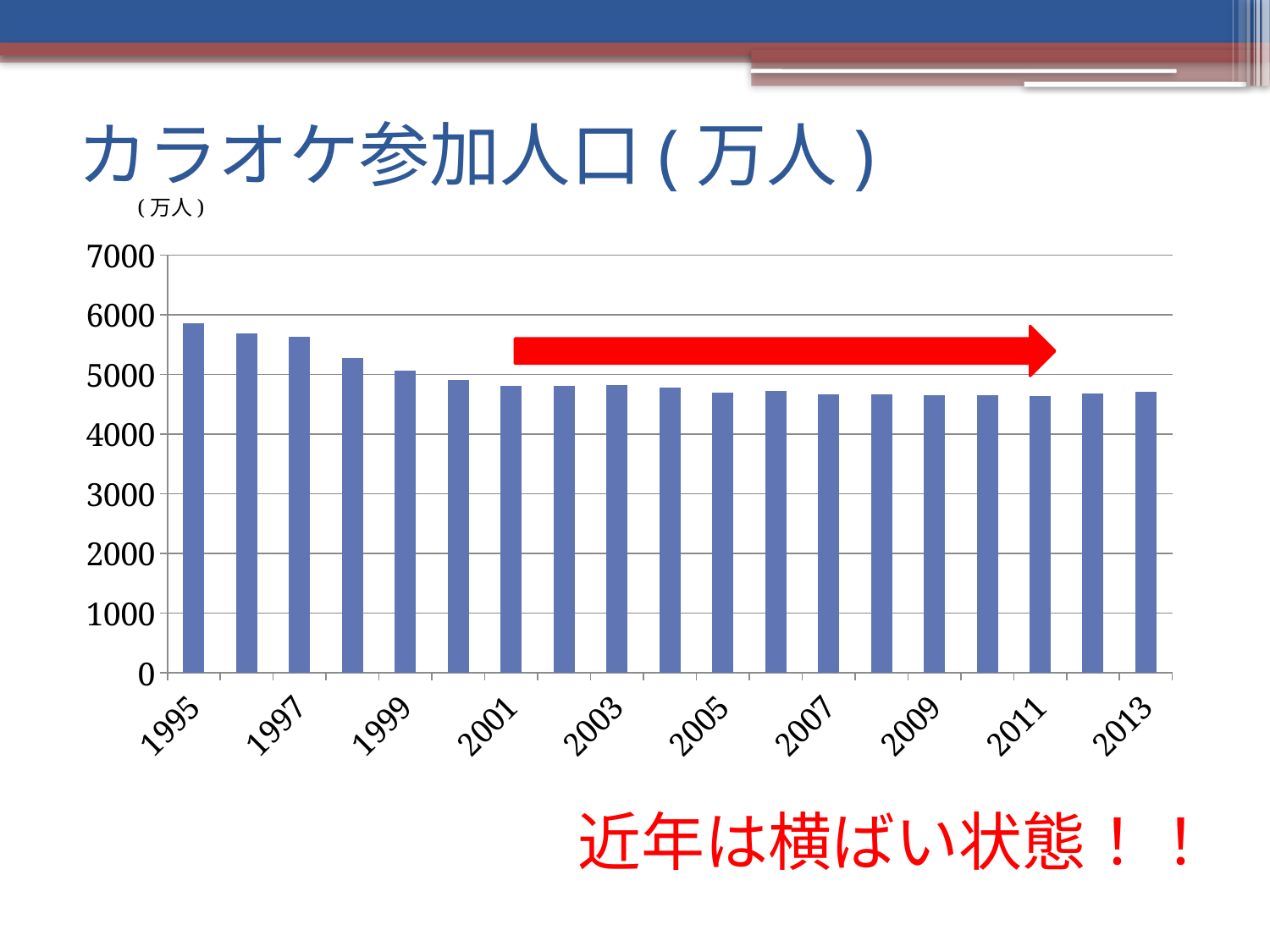
Which year has the highest karaoke participation population? 1995 Is the value for 2013 greater or less than 5000? less Is the value for 1995 greater or less than 5000? greater Is the value for 2007 greater or less than 4000? greater What is the title of the chart? カラオケ参加人口(万人) What kind of chart is shown on the slide? bar chart Which is larger, the value for 1997 or the value for 2005? 1997 How many years (bars) are plotted in the chart? 19 What unit is shown above the vertical axis of the chart? (万人) Which is larger, the value for 1995 or the value for 2013? 1995 Do the values generally rise or fall from 1995 to 2013? fall